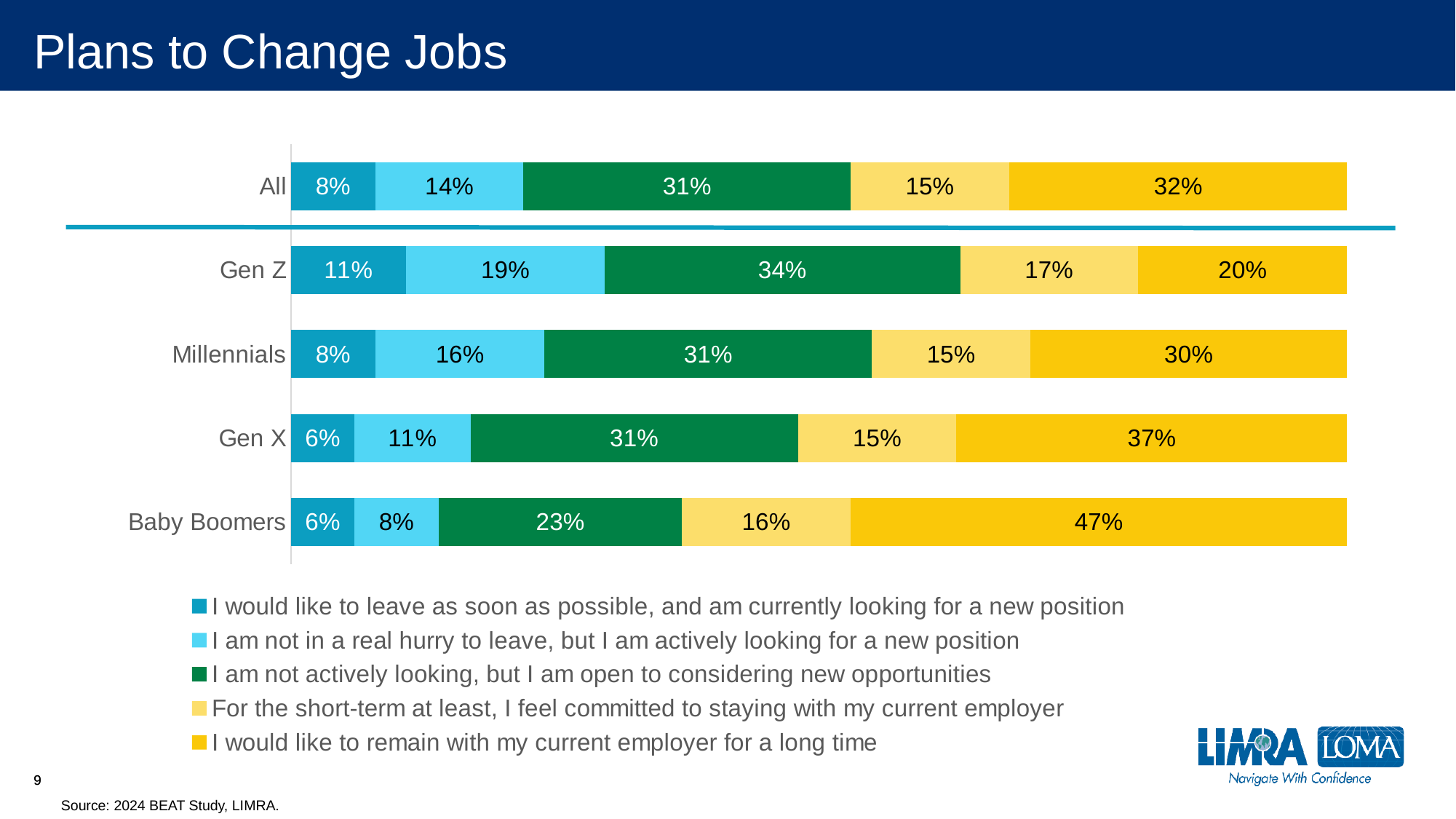
What percentage of Baby Boomers would like to remain with their current employer for a long time? 47% How many categories (groups) are plotted on the chart? 5 What is the source cited for the chart? 2024 BEAT Study, LIMRA. What kind of chart is shown on the slide? Stacked bar chart Which group has the lowest share who would like to remain with their current employer for a long time? Gen Z What percentage of Gen Z respondents are not actively looking but open to considering new opportunities? 34% What percentage of Millennials are not in a real hurry to leave but are actively looking for a new position? 16% What is the title of the chart? Plans to Change Jobs Which group has a larger share who would like to leave as soon as possible: Gen Z or Gen X? Gen Z What is the difference between Gen X and Gen Z in the share who would like to remain with their current employer for a long time? 17 percentage points Which group has the highest share who would like to remain with their current employer for a long time? Baby Boomers How many series does the legend list? 5